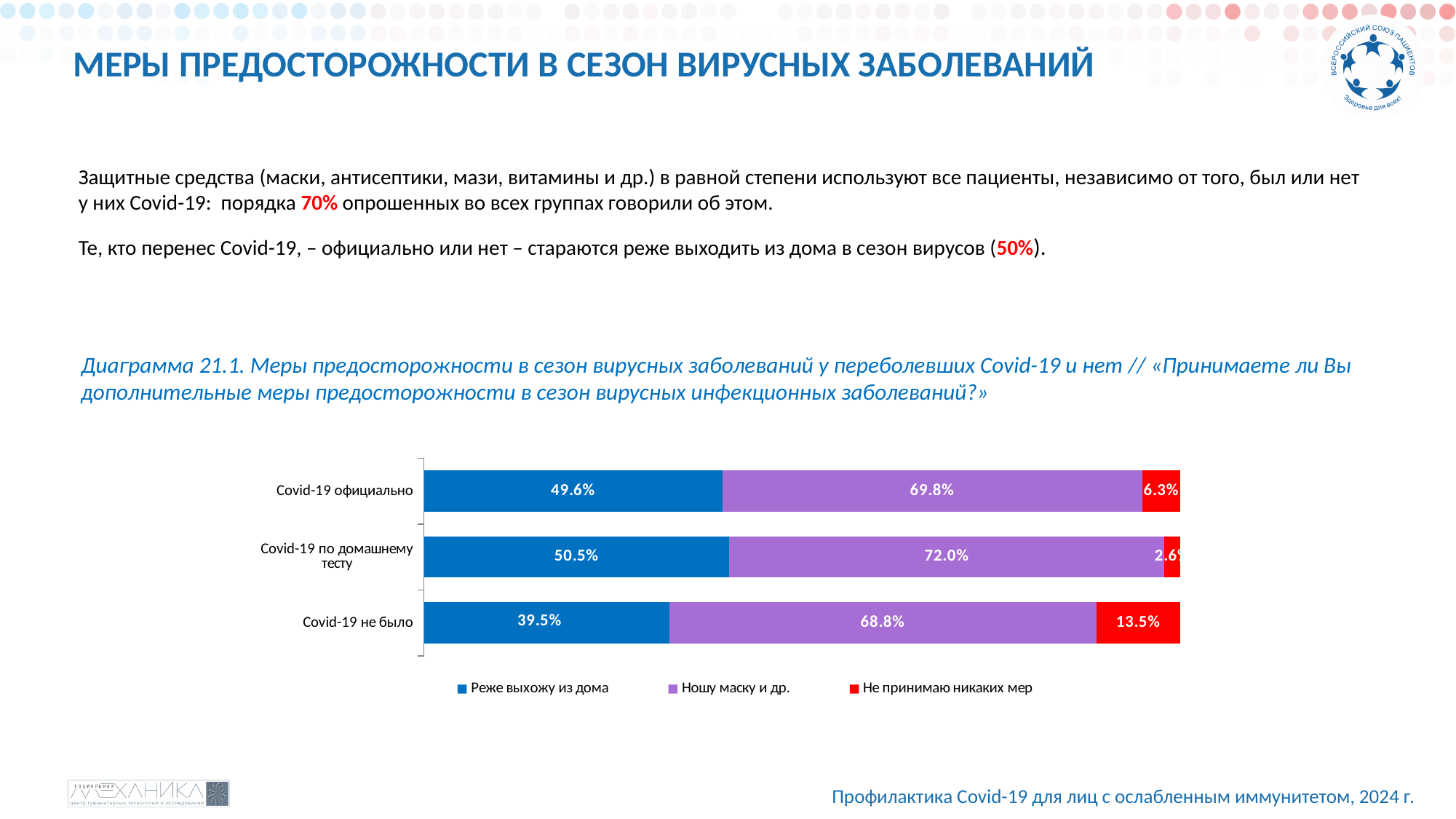
Which group has the highest value for 'Не принимаю никаких мер'? Covid-19 не было Which group has the highest value for 'Ношу маску и др.'? Covid-19 по домашнему тесту What is the value of 'Ношу маску и др.' for the 'Covid-19 не было' group? 68.8% What is the value of 'Ношу маску и др.' for the 'Covid-19 по домашнему тесту' group? 72.0% How many groups (categories) are shown on the chart? 3 What is the difference in 'Не принимаю никаких мер' between the 'Covid-19 не было' group and the 'Covid-19 официально' group? 7.2 percentage points Which group has the lowest value for 'Реже выхожу из дома'? Covid-19 не было What share of the 'Covid-19 не было' group answered 'Не принимаю никаких мер'? 13.5% What percentage of respondents in the 'Covid-19 официально' group chose 'Реже выхожу из дома'? 49.6% What is the difference in 'Реже выхожу из дома' between the 'Covid-19 по домашнему тесту' group and the 'Covid-19 официально' group? 0.9 percentage points What type of chart is shown on the slide? Stacked bar chart How many series does the legend list? 3